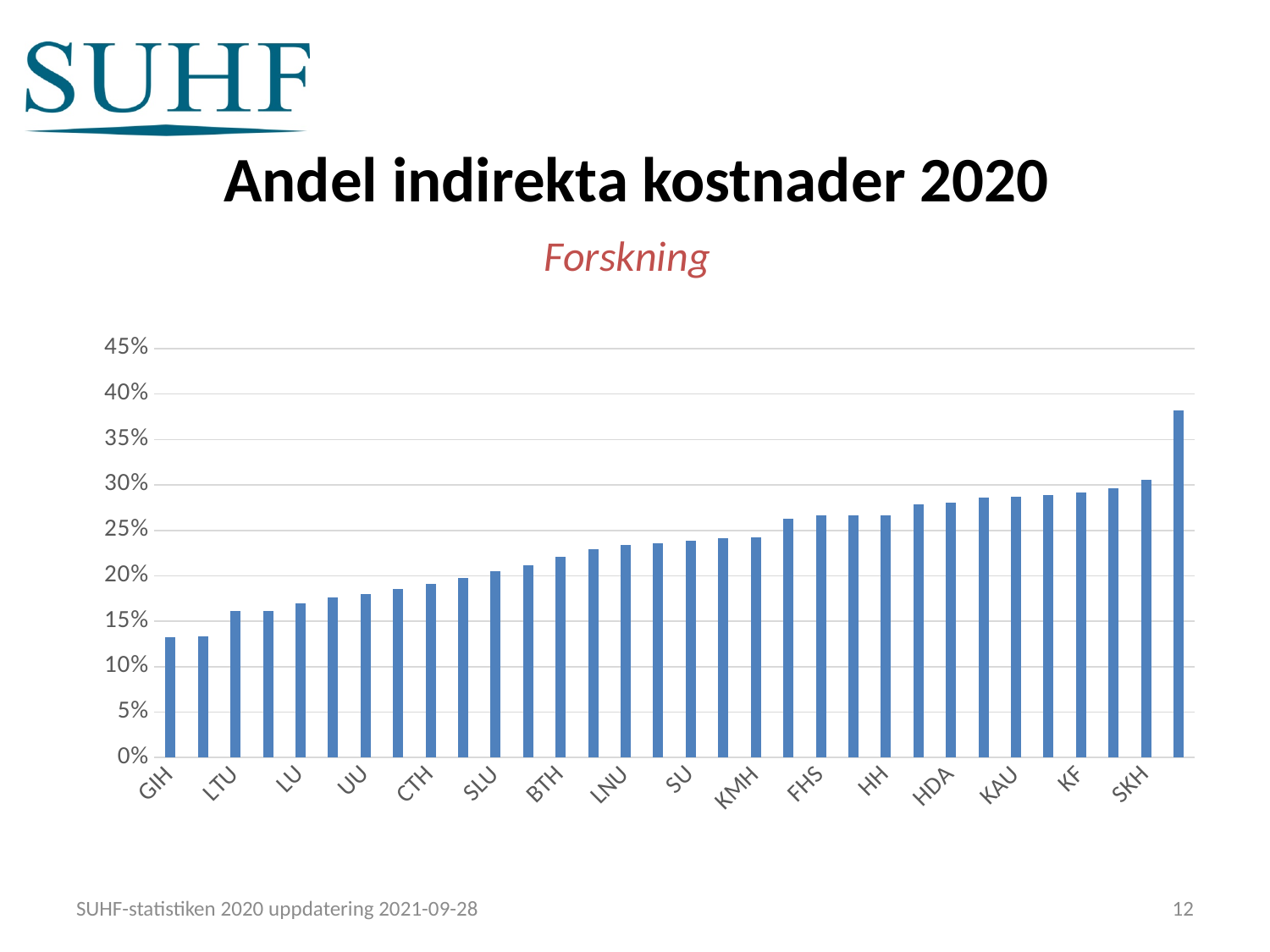
Is the value for UU greater or less than 20%? less Is the value for BTH greater or less than 20%? greater Is the value for HDA greater or less than 30%? less What is the title of the chart on the slide? Andel indirekta kostnader 2020 What subtitle appears in red italics below the chart title? Forskning Do the bar values rise or fall from left to right along the x axis? rise What kind of chart is shown on the slide? bar chart Which has the larger value, SKH or GIH? SKH